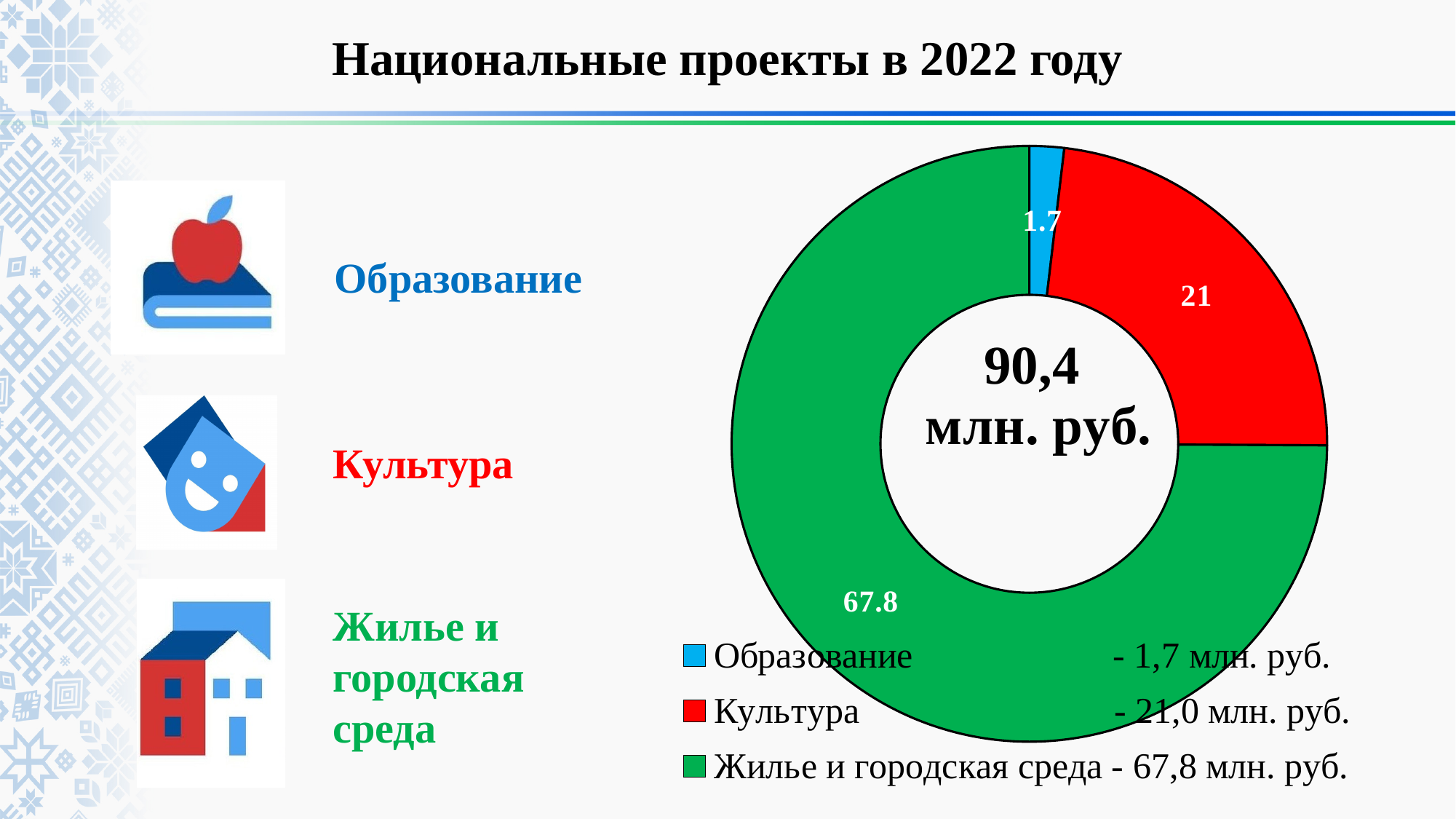
What is the difference between the values for Культура and Образование? 19.3 Which is larger, the value for Культура or the value for Образование? Культура How many categories does the chart show? 3 What is the value shown for Образование on the chart? 1.7 Which category has the largest slice of the chart? Жилье и городская среда What is the difference between the values for Жилье и городская среда and Культура? 46.8 What kind of chart is shown on the slide? Donut (pie) chart What total amount is printed in the centre of the donut chart? 90,4 млн. руб. What is the value shown for Культура on the chart? 21 What is the value shown for Жилье и городская среда on the chart? 67.8 Which category has the smallest slice of the chart? Образование